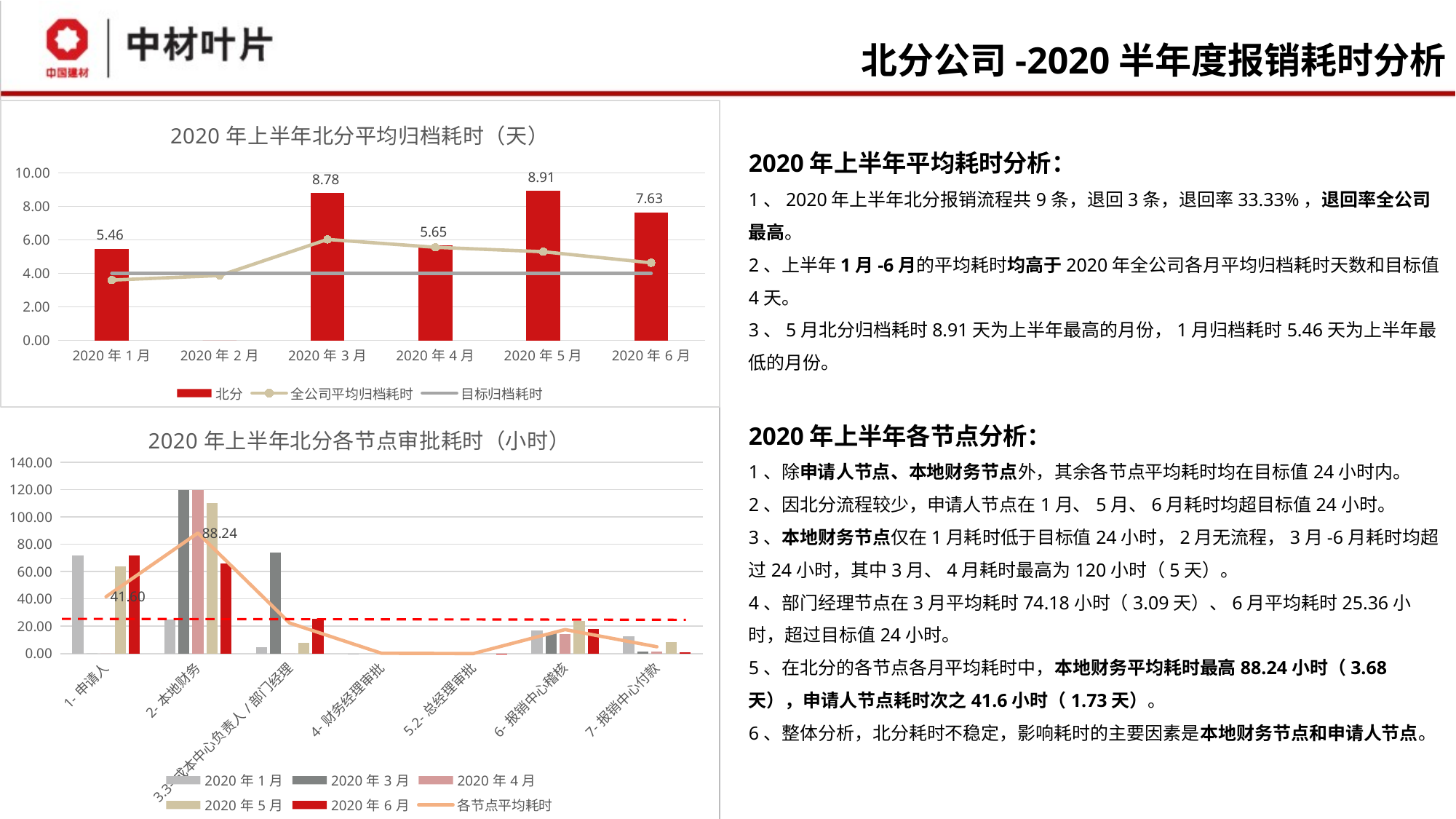
What kind of chart is the top chart (2020年上半年北分平均归档耗时)? Bar chart with lines In the top chart (2020年上半年北分平均归档耗时), what is the 北分 value for 2020年5月? 8.91 In the bottom chart (2020年上半年北分各节点审批耗时), how many node categories are shown on the x axis? 7 In the top chart (2020年上半年北分平均归档耗时), how many series does the legend list? 3 In the top chart (2020年上半年北分平均归档耗时), what is the 北分 value for 2020年6月? 7.63 In the top chart (2020年上半年北分平均归档耗时), which month has the highest 北分 bar? 2020年5月 In the bottom chart (2020年上半年北分各节点审批耗时), how many series does the legend list? 6 In the top chart (2020年上半年北分平均归档耗时), which is larger, the 北分 value for 2020年3月 or for 2020年6月? 2020年3月 In the bottom chart (2020年上半年北分各节点审批耗时), what is the 各节点平均耗时 value for 2-本地财务? 88.24 In the top chart (2020年上半年北分平均归档耗时), what is the difference between the 北分 values for 2020年5月 and 2020年1月? 3.45 In the bottom chart (2020年上半年北分各节点审批耗时), is the 2020年3月 value for 2-本地财务 greater or less than 100? greater In the bottom chart (2020年上半年北分各节点审批耗时), what is the 各节点平均耗时 value for 1-申请人? 41.60